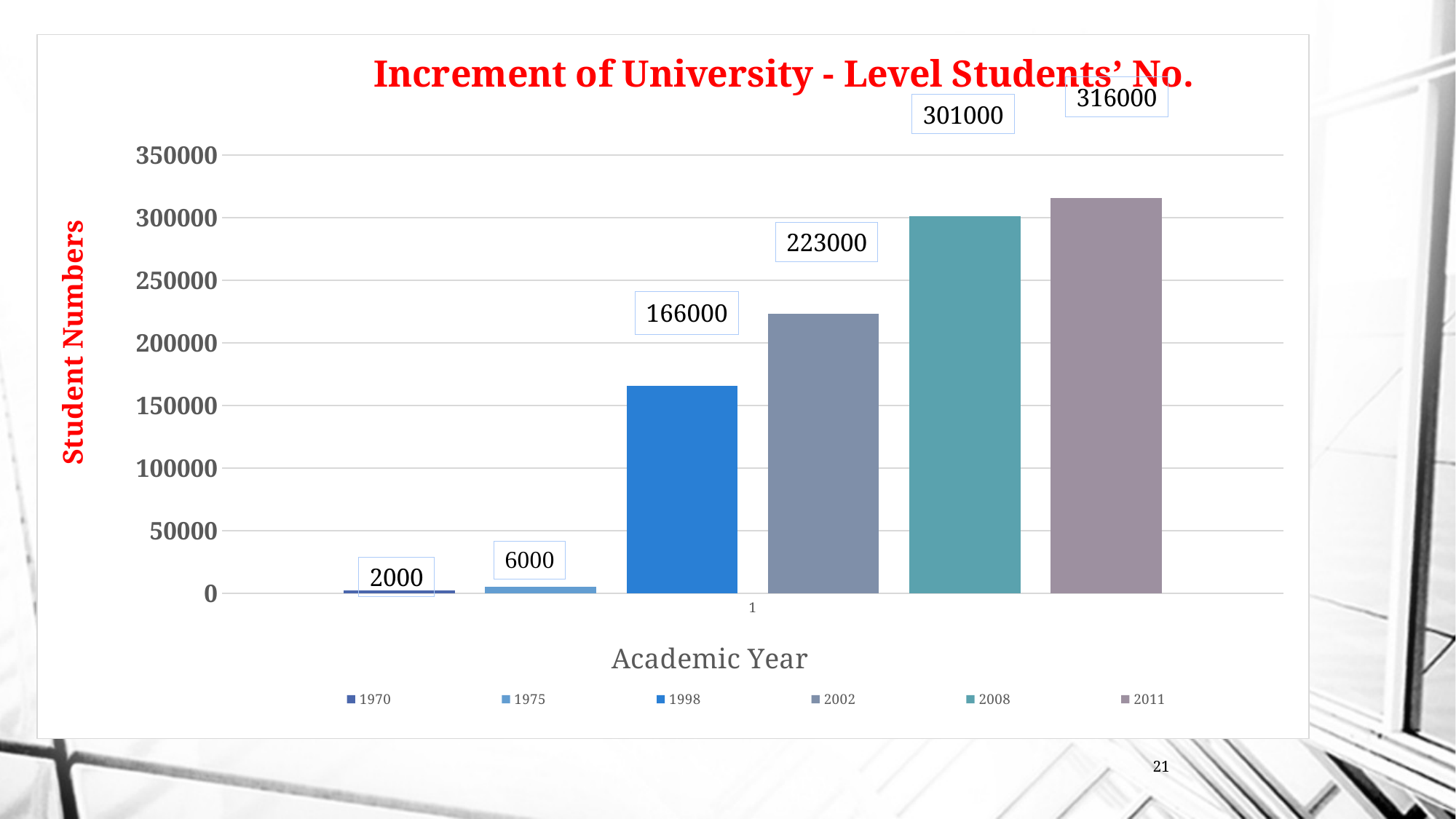
Which year has the lowest student number? 1970 How many series does the legend list? 6 What is the title of the chart? Increment of University - Level Students' No. What is the difference between the values for 2011 and 2008? 15000 Which year has the highest student number? 2011 What is the value for 2008? 301000 Is the value for 2002 greater or less than 200000? greater What is the value for 1970? 2000 What is the difference between the values for 2002 and 1998? 57000 What kind of chart is shown? bar chart What is the value for 1998? 166000 Which is larger, the value for 1975 or the value for 1970? 1975